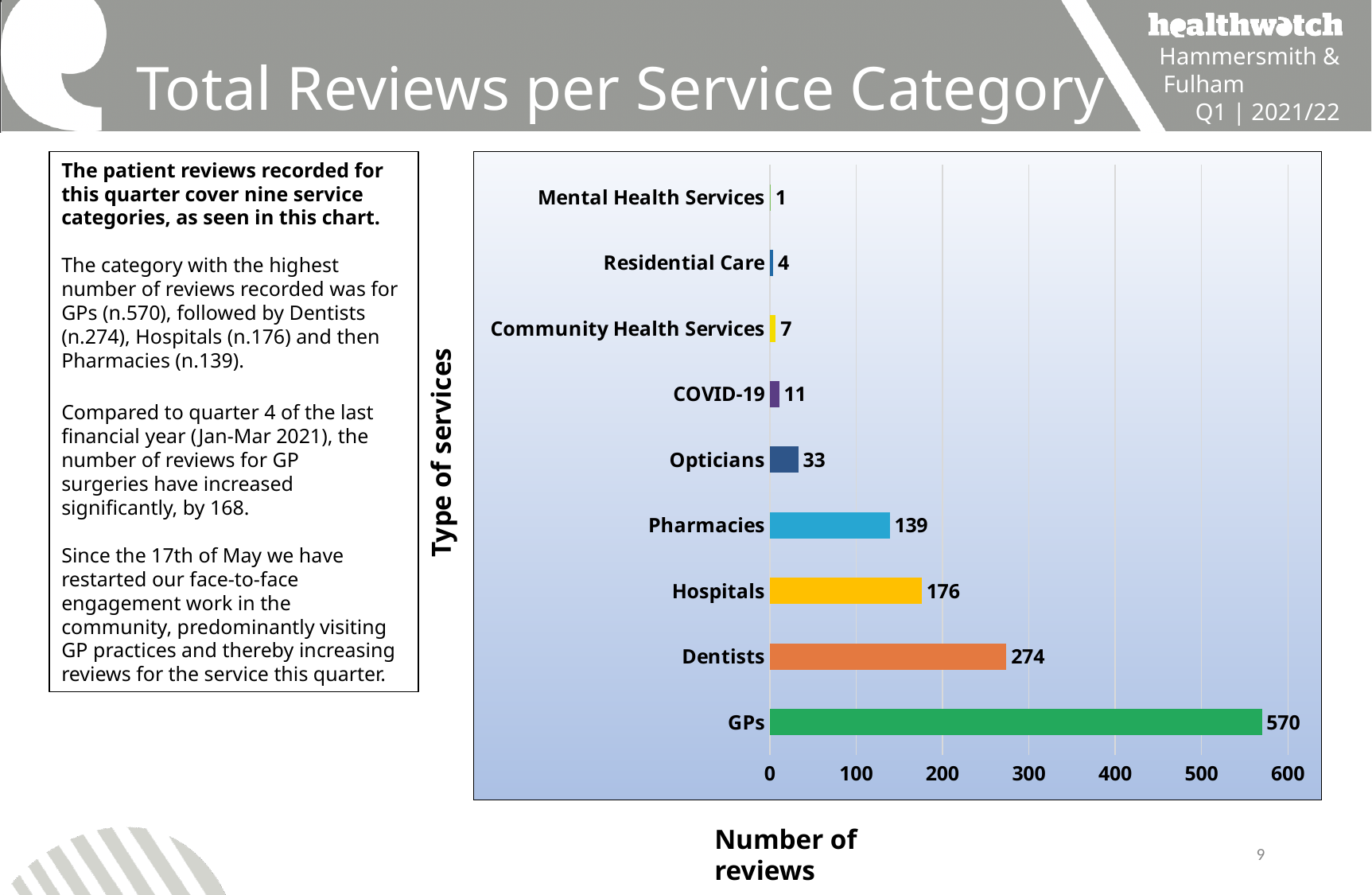
Which service category has the highest number of reviews? GPs Which has more reviews, Residential Care or Community Health Services? Community Health Services What is the difference in reviews between GPs and Dentists? 296 How many reviews were recorded for COVID-19? 11 What is the label of the horizontal axis of the chart? Number of reviews Is the value for Dentists greater or less than 300? less What is the difference in reviews between Hospitals and Pharmacies? 37 What type of chart is shown on the slide? bar chart How many service categories are shown in the chart? 9 How many reviews were recorded for Pharmacies? 139 Which service category has the lowest number of reviews? Mental Health Services What is the number of reviews for Opticians? 33